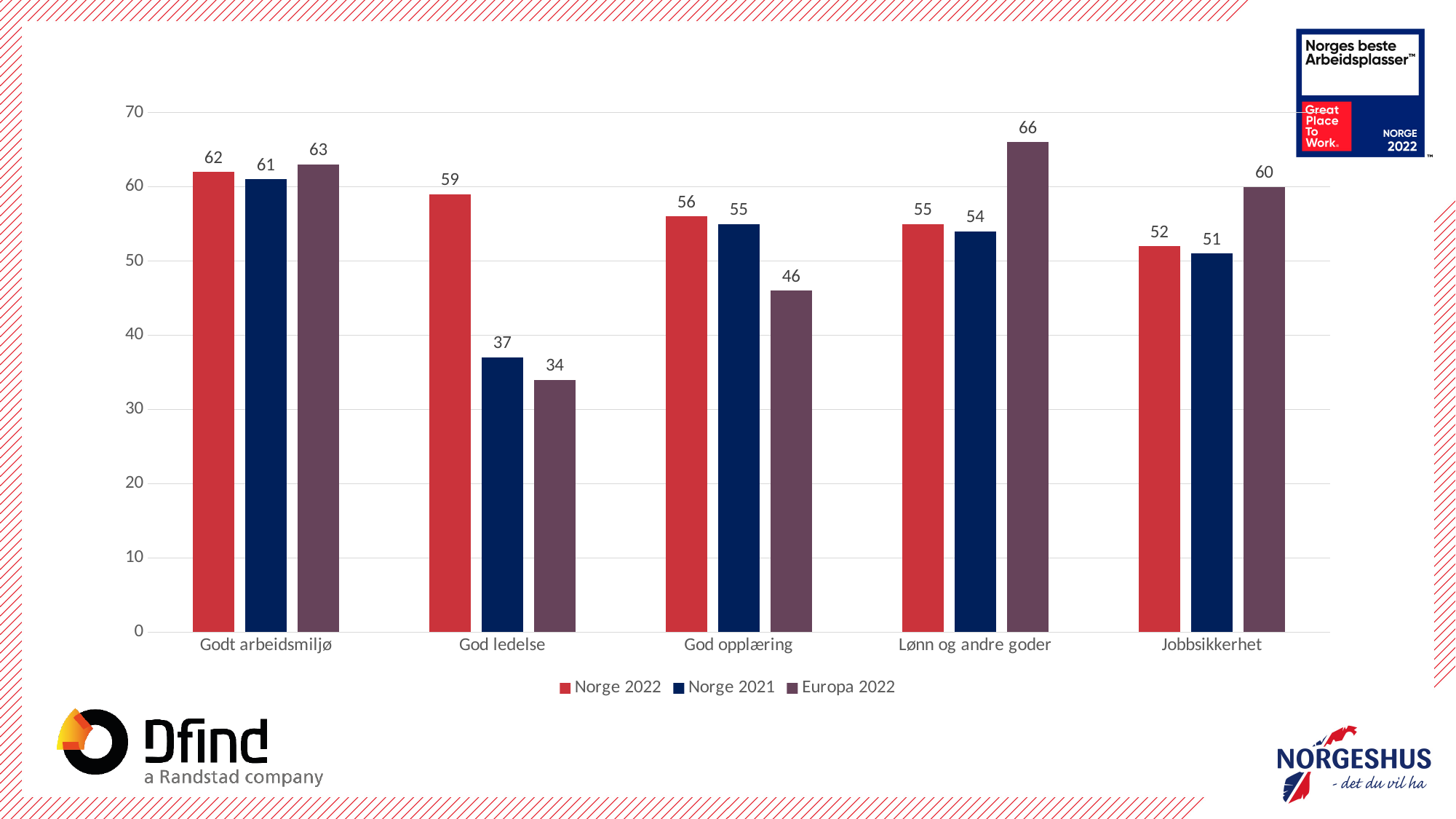
Do the Norge 2022 values rise or fall from Godt arbeidsmiljø to Jobbsikkerhet? Fall What is the value for Europa 2022 in the God ledelse category? 34 What is the value for Norge 2022 in the Godt arbeidsmiljø category? 62 Which colour represents the Norge 2021 series in the legend? Dark blue How many series does the legend list? 3 What is the difference between Norge 2022 and Europa 2022 in the God ledelse category? 25 What is the value for Norge 2021 in the Lønn og andre goder category? 54 How many categories are shown on the x axis? 5 Which category has the highest value for Europa 2022? Lønn og andre goder Which is larger in the Jobbsikkerhet category: Norge 2022 or Europa 2022? Europa 2022 What kind of chart is shown on the slide? Bar chart Which category has the lowest value for Norge 2021? God ledelse